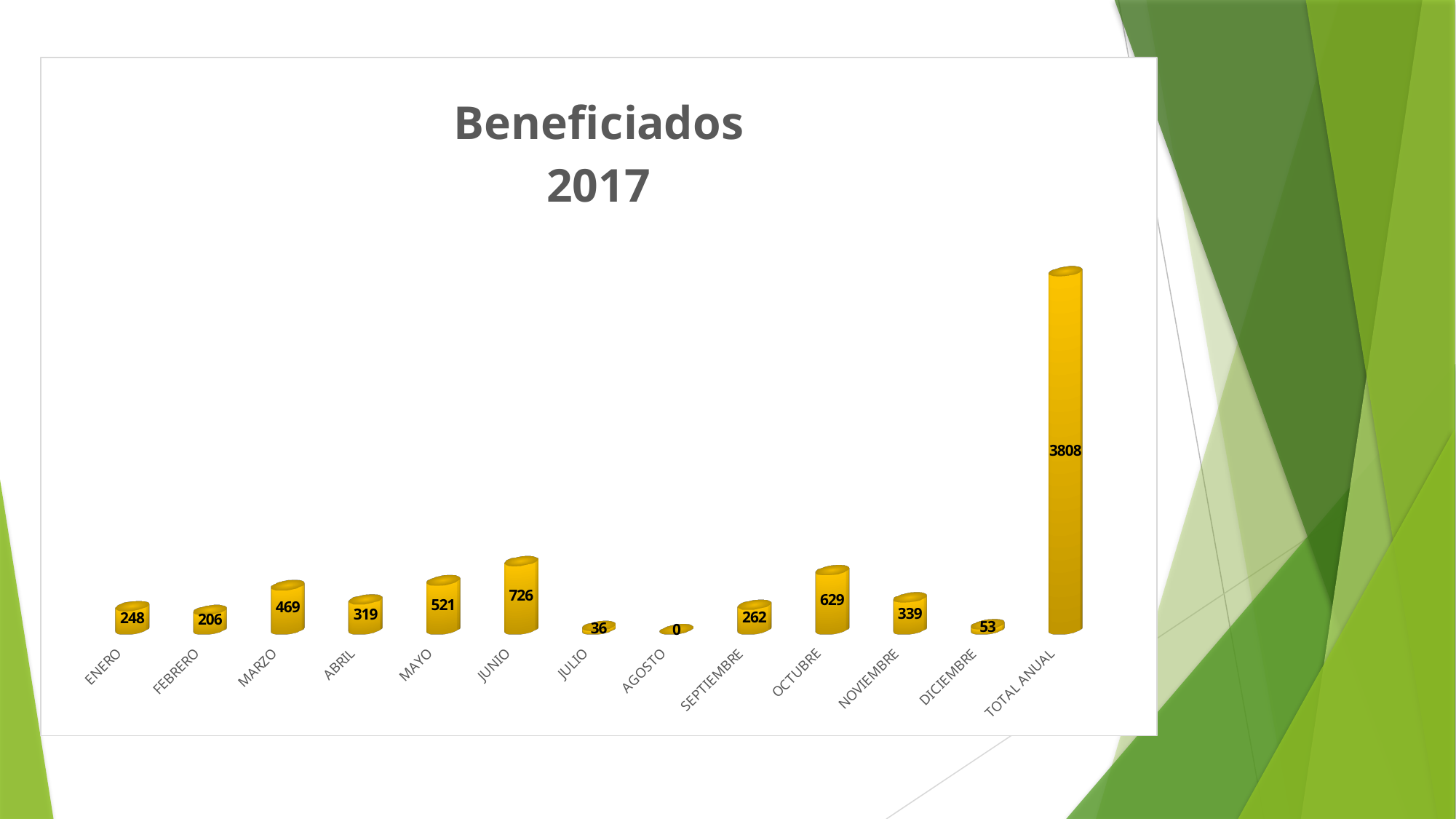
What is the value for OCTUBRE? 629 Which is larger, the value for MARZO or the value for ABRIL? MARZO What is the difference between the values for ENERO and FEBRERO? 42 What is the value for AGOSTO? 0 What is the value for TOTAL ANUAL? 3808 What is the title of the chart? Beneficiados 2017 What is the difference between the values for JUNIO and MAYO? 205 Which month has the highest value? JUNIO What is the value for JUNIO? 726 How many categories are shown on the x axis? 13 What kind of chart is this? bar chart Which category has the lowest value? AGOSTO